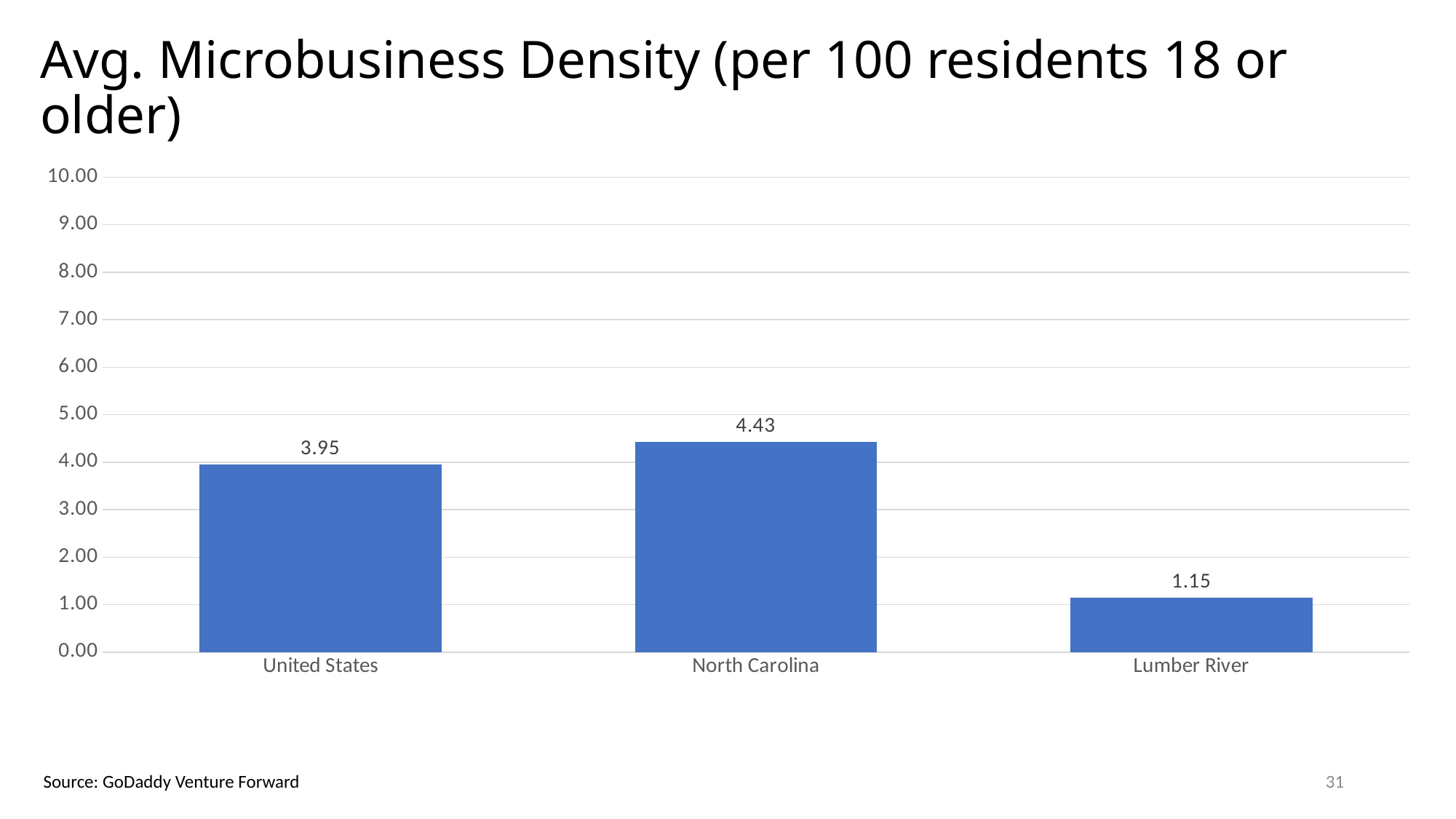
What is the difference between the North Carolina and United States values? 0.48 What kind of chart is shown on the slide? Bar chart What is the average microbusiness density for North Carolina? 4.43 What is the difference between the United States and Lumber River values? 2.80 Which category has the lowest average microbusiness density? Lumber River Is the value for North Carolina greater or less than 4.00? greater How many categories are shown on the chart? 3 What is the source cited for the chart? GoDaddy Venture Forward What is the average microbusiness density for Lumber River? 1.15 Which is larger, the value for the United States or the value for Lumber River? United States What is the average microbusiness density for the United States? 3.95 Which category has the highest average microbusiness density? North Carolina